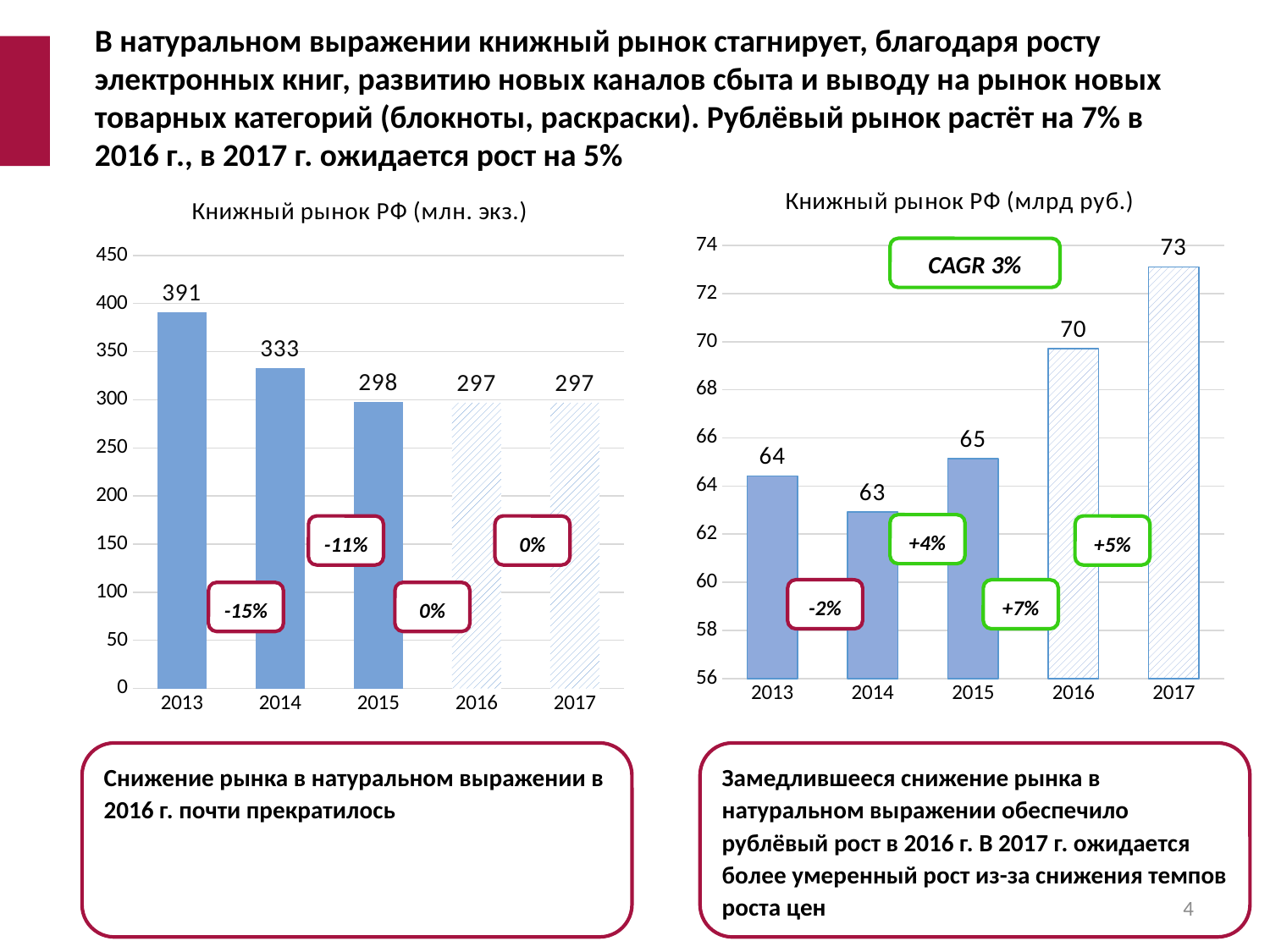
In the chart titled "Книжный рынок РФ (млрд руб.)", what is the value for 2017? 73 In the chart titled "Книжный рынок РФ (млрд руб.)", what is the difference between the 2017 and 2016 values? 3 In the chart titled "Книжный рынок РФ (млрд руб.)", what is the value for 2014? 63 In the chart titled "Книжный рынок РФ (млн. экз.)", which year has the highest value? 2013 What kind of chart is the chart titled "Книжный рынок РФ (млрд руб.)"? bar chart In the chart titled "Книжный рынок РФ (млрд руб.)", which year has the lowest value? 2014 In the chart titled "Книжный рынок РФ (млн. экз.)", do the values rise or fall from 2013 to 2015? fall In the chart titled "Книжный рынок РФ (млрд руб.)", which is larger, the value for 2016 or the value for 2015? 2016 In the chart titled "Книжный рынок РФ (млн. экз.)", how many years are shown on the x axis? 5 In the chart titled "Книжный рынок РФ (млн. экз.)", what is the value for 2015? 298 In the chart titled "Книжный рынок РФ (млн. экз.)", what is the difference between the 2013 and 2014 values? 58 In the chart titled "Книжный рынок РФ (млн. экз.)", what is the value for 2013? 391